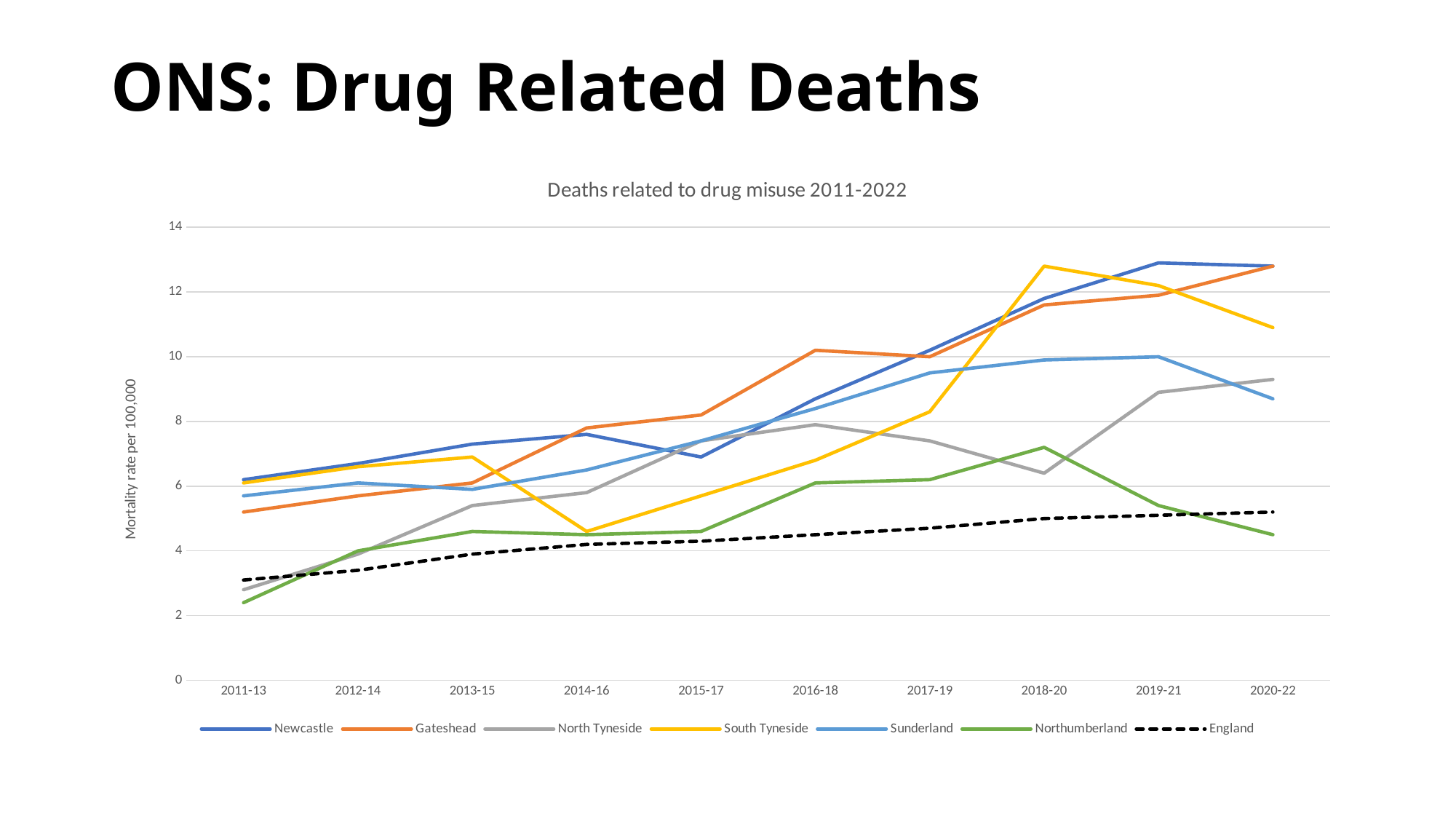
How many time periods are shown along the x axis? 10 Which area has the highest mortality rate in 2018-20? South Tyneside What kind of chart is shown on the slide? line chart Which area has the lowest mortality rate in 2011-13? Northumberland Is the value for England in 2011-13 greater or less than 4? less In 2016-18, which is higher: Gateshead or Sunderland? Gateshead Is the value for South Tyneside in 2018-20 greater or less than 12? greater Is the value for Northumberland in 2020-22 greater or less than 6? less Which series is drawn as a dashed line? England How many series does the legend list? 7 Does the England line rise or fall from 2011-13 to 2020-22? rises What is the title of the chart? Deaths related to drug misuse 2011-2022